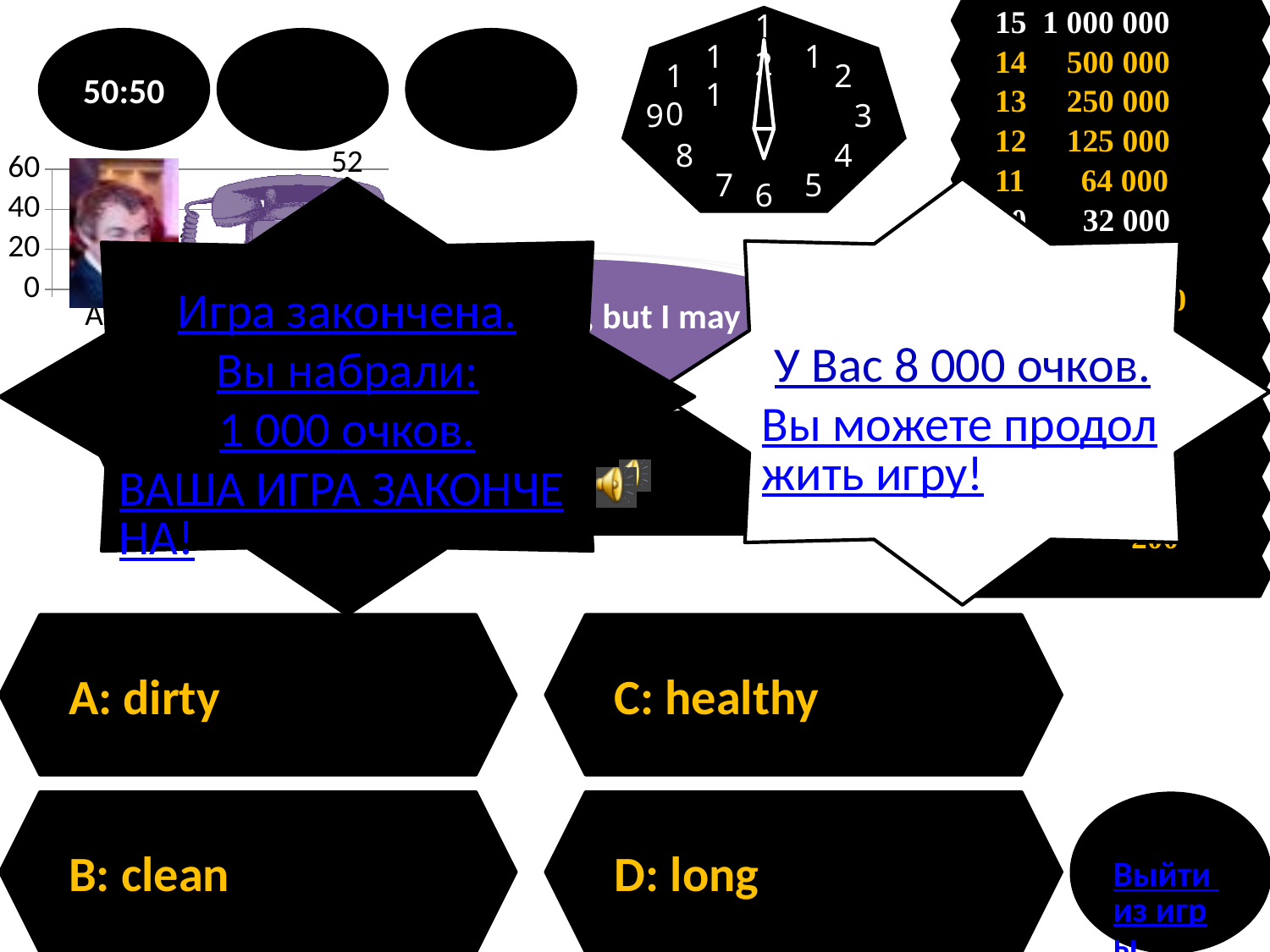
On the chart in the top-left corner of the slide, what is the highest tick value shown on the vertical axis? 60 On the chart in the top-left corner of the slide, is the visible data label value 52 greater or less than 40? greater On the chart in the top-left corner of the slide, what data label value is visible above the plotted bar? 52 On the chart in the top-left corner of the slide, what is the lowest tick value shown on the vertical axis? 0